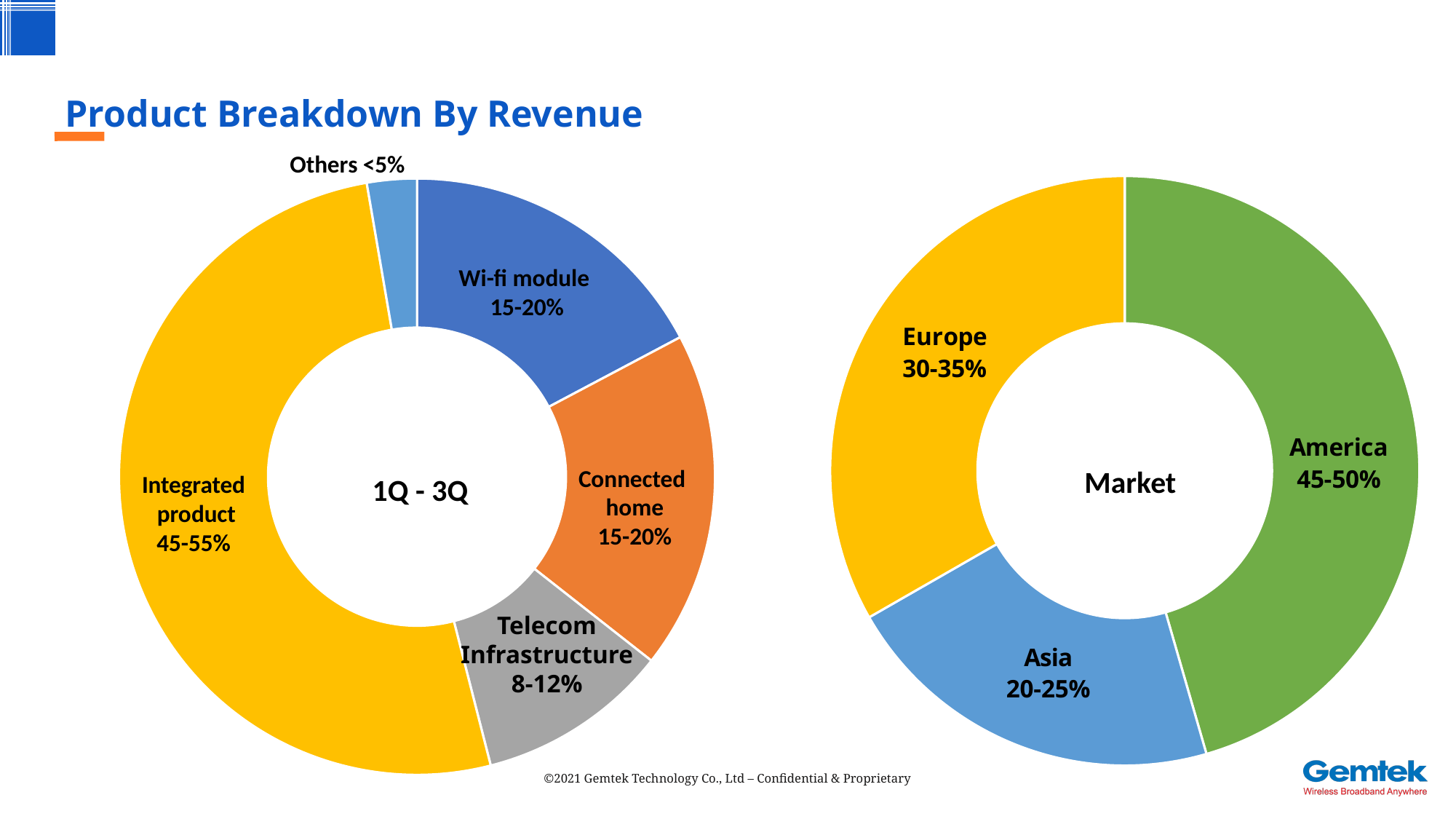
What kind of chart is the right chart (Market)? Pie (donut) chart On the left chart (1Q - 3Q), what share is labelled for Telecom Infrastructure? 8-12% On the right chart (Market), what share is labelled for Asia? 20-25% On the left chart (1Q - 3Q), what share is labelled for Others? <5% How many categories are shown on the left chart (1Q - 3Q)? 5 On the left chart (1Q - 3Q), which category has the smallest slice? Others On the left chart (1Q - 3Q), what share of revenue is labelled for Integrated product? 45-55% On the left chart (1Q - 3Q), which category has the largest slice? Integrated product On the right chart (Market), what share is labelled for America? 45-50% On the left chart (1Q - 3Q), what share is labelled for Wi-fi module? 15-20% On the right chart (Market), which is larger, Europe or America? America On the right chart (Market), which region has the smallest slice? Asia